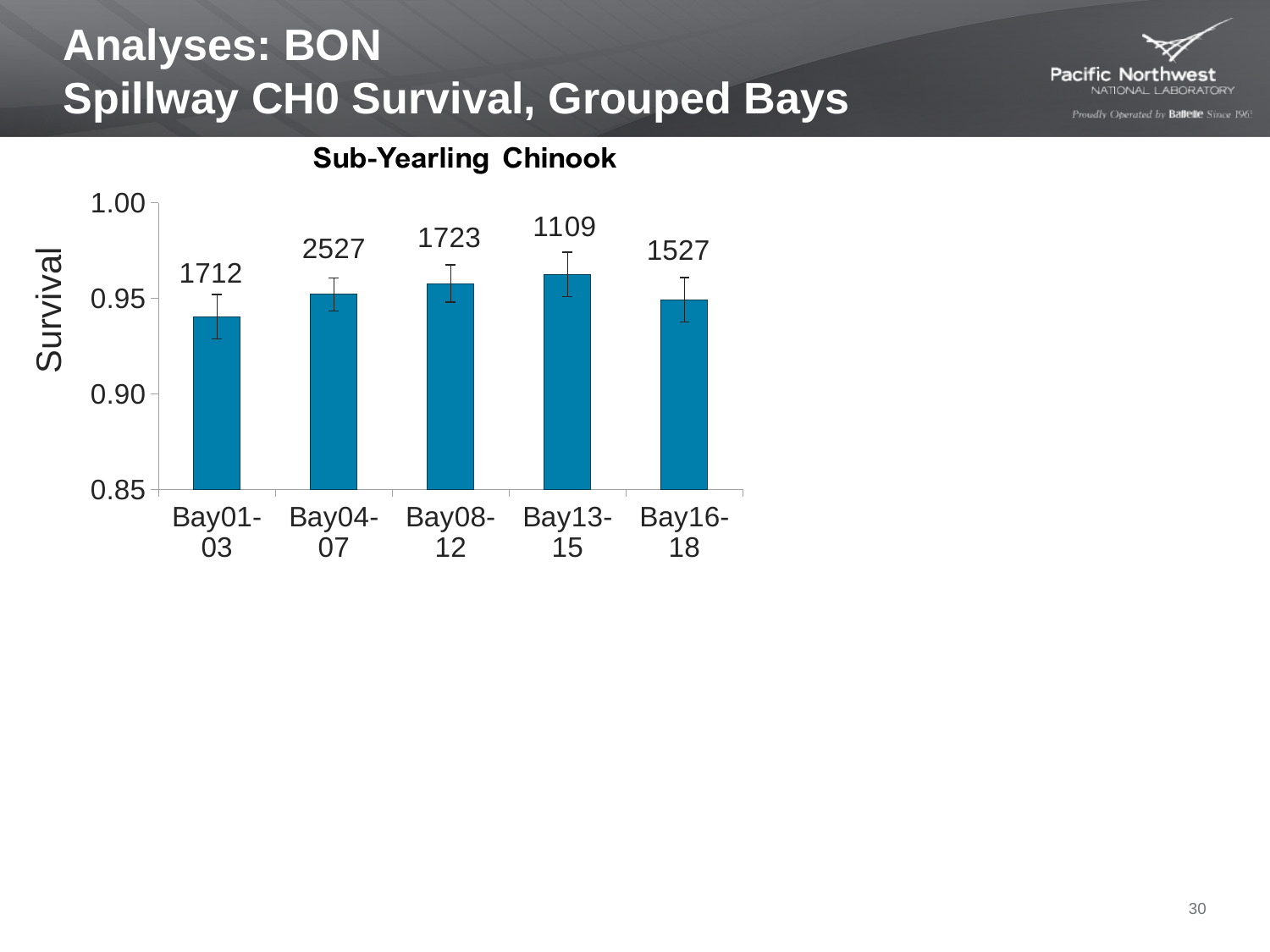
Which has the higher survival, Bay01-03 or Bay13-15? Bay13-15 Which bay group has the highest survival? Bay13-15 Is the survival value for Bay01-03 greater or less than 0.95? less What kind of chart is shown on the slide? bar chart Is the survival value for Bay13-15 greater or less than 0.95? greater Is the survival value for Bay16-18 greater or less than 0.90? greater Which bay group has the lowest survival? Bay01-03 What number is printed above the bar for Bay04-07? 2527 What number is printed above the bar for Bay13-15? 1109 What is the label on the y axis of the chart? Survival How many bay groups are shown on the x axis of the chart? 5 What is the title of the chart? Sub-Yearling Chinook